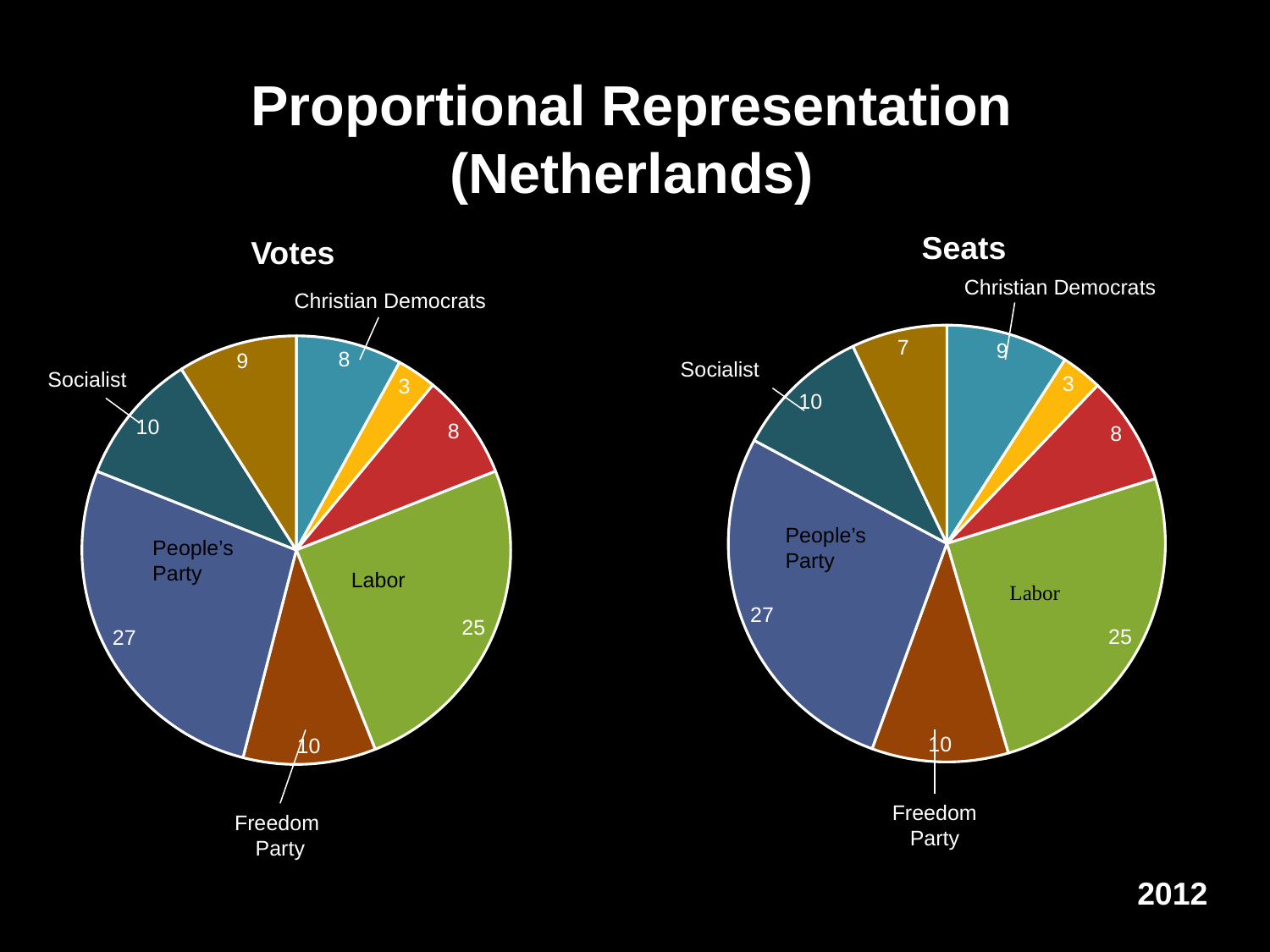
In the Votes pie chart, what is the value for Labor? 25 In the Seats pie chart, what is the value for the Socialist slice? 10 What is the title of the chart on the left? Votes In the Votes pie chart, what is the value for the People's Party? 27 How many slices does the Votes pie chart have? 8 In the Votes pie chart, which labelled party has the largest slice? People's Party Is the Christian Democrats value larger in the Votes chart or the Seats chart? Seats What type of chart is used to show Seats? Pie chart In the Seats pie chart, what is the difference between the Christian Democrats value and the Freedom Party value? 1 In the Seats pie chart, what is the value for the Christian Democrats? 9 In the Seats pie chart, which labelled party has the largest slice? People's Party In the Votes pie chart, what is the difference between the People's Party value and the Labor value? 2